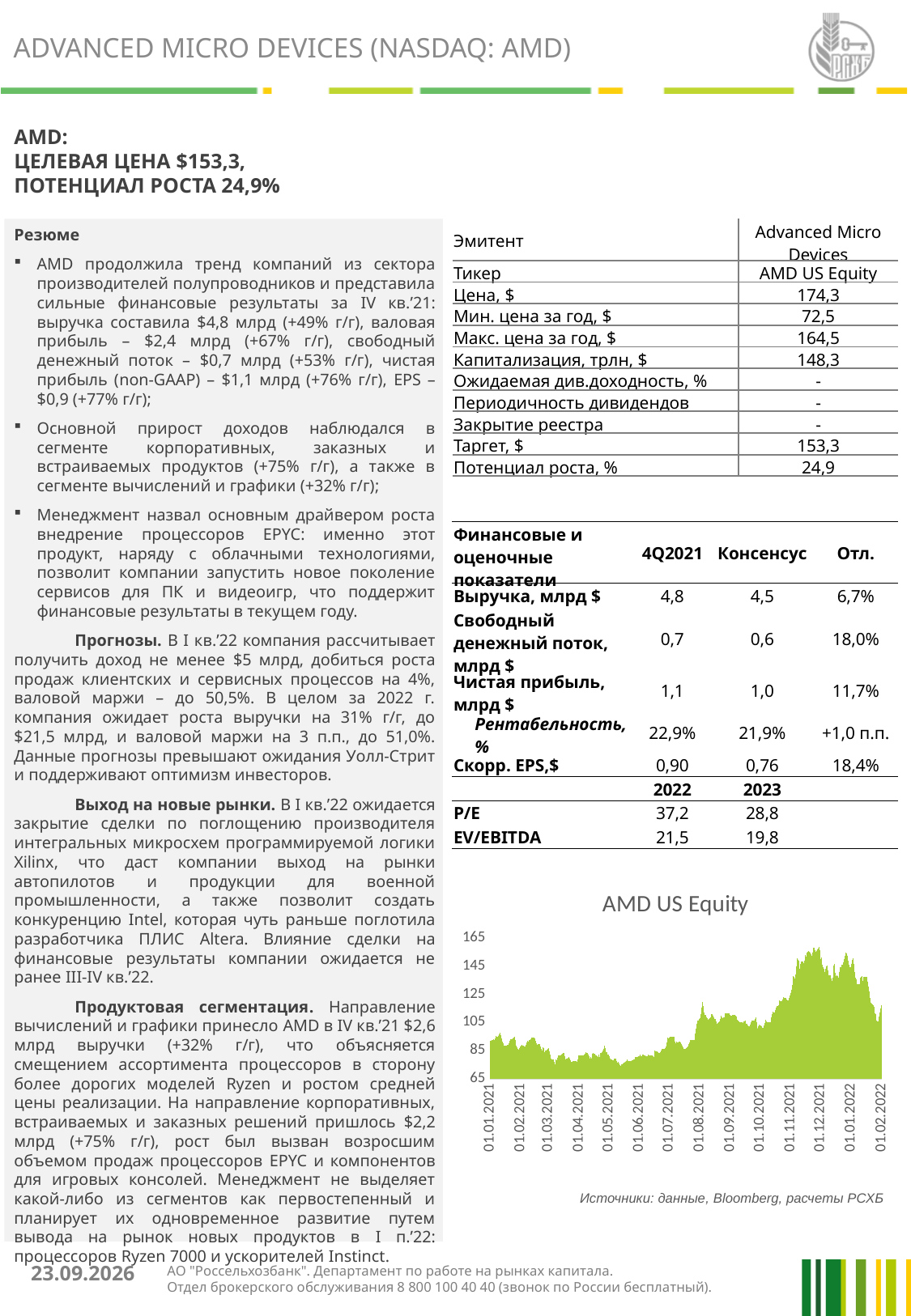
What kind of chart is the "AMD US Equity" chart? area chart In the "AMD US Equity" chart, is the highest value reached greater or less than 145? greater In the "AMD US Equity" chart, is the value at 01.12.2021 greater or less than 125? greater In the "AMD US Equity" chart, is the lowest value reached greater or less than 85? less In the "AMD US Equity" chart, does the value rise or fall between 01.12.2021 and 01.02.2022? fall In the "AMD US Equity" chart, does the value rise or fall between 01.09.2021 and 01.12.2021? rise In the "AMD US Equity" chart, is the value at 01.12.2021 larger or smaller than the value at 01.05.2021? larger What is the title of the chart on the slide? AMD US Equity What is the highest tick value shown on the y axis of the "AMD US Equity" chart? 165 How many date labels are shown on the x axis of the "AMD US Equity" chart? 14